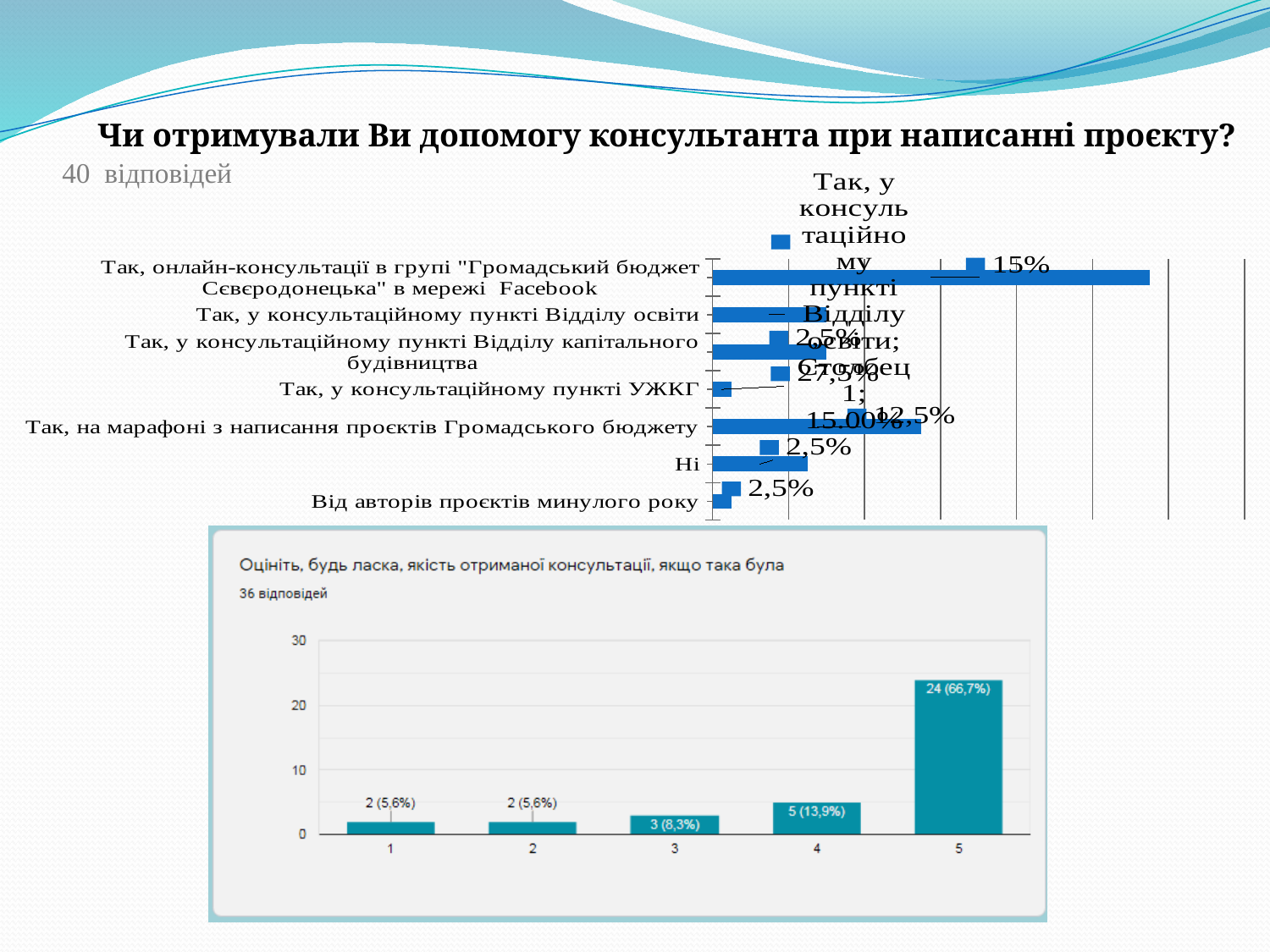
Do the values in the bottom chart rise or fall as the rating increases from 1 to 5? rise In the bottom chart, what is the data label on the bar for rating 3? 3 (8,3%) In the bottom chart, is the value for rating 5 greater or less than 20? greater In the bottom chart, which has more responses: rating 3 or rating 4? Rating 4 In the top chart, which category has the longest bar? Так, онлайн-консультації в групі "Громадський бюджет Сєвєродонецька" в мережі Facebook In the bottom chart (Оцініть, будь ласка, якість отриманої консультації), what is the data label on the bar for rating 5? 24 (66,7%) How many rating categories are shown on the x axis of the bottom chart? 5 How many responses does the bottom chart report (as stated under its title)? 36 відповідей In the bottom chart, what is the difference in the number of responses between rating 5 and rating 4? 19 In the bottom chart, what is the data label on the bar for rating 4? 5 (13,9%) What kind of chart is the top chart (Чи отримували Ви допомогу консультанта при написанні проєкту?)? Bar chart In the bottom chart, which rating has the highest number of responses? 5